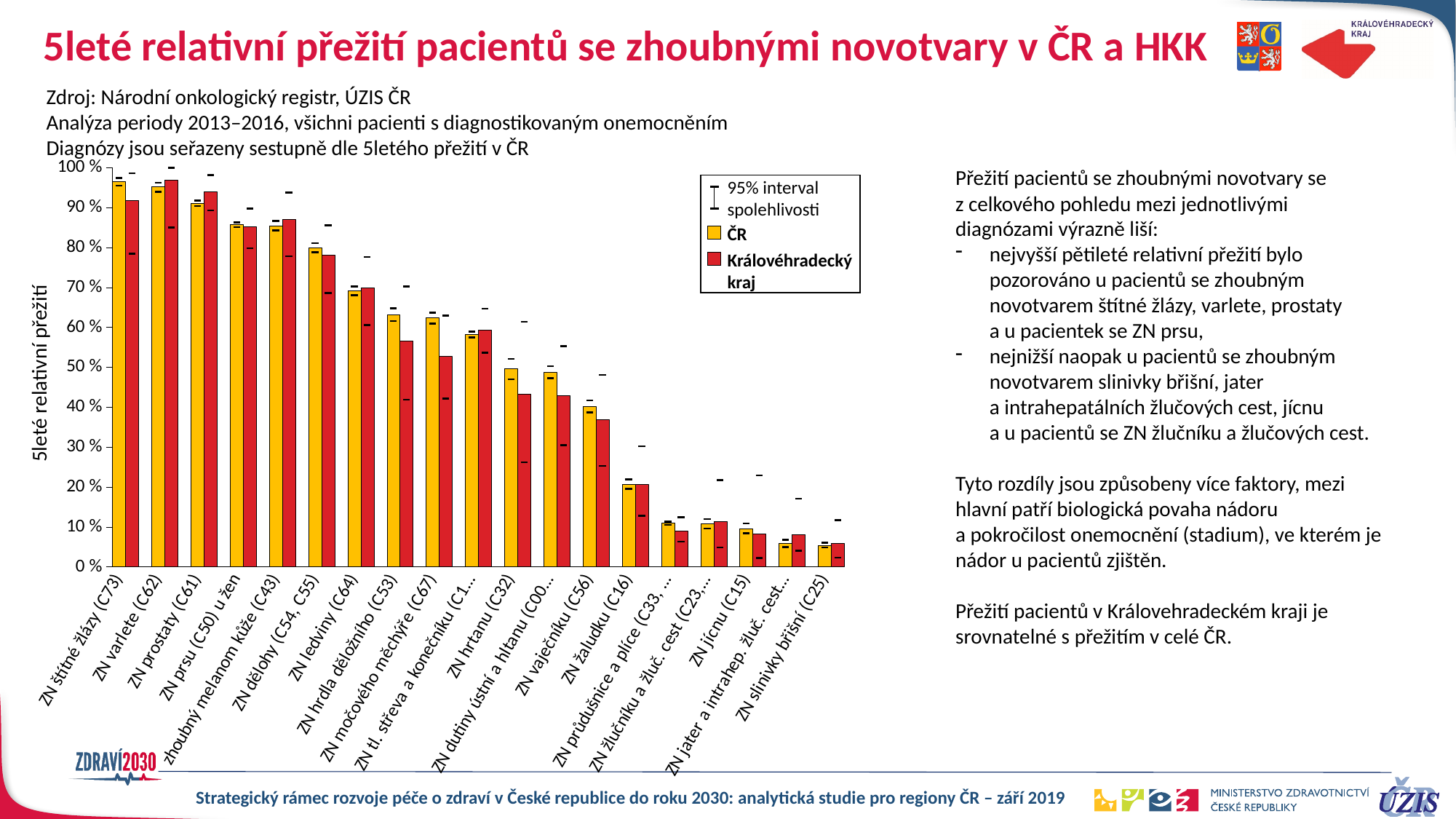
Which diagnosis has the highest 5-year relative survival for ČR? ZN štítné žlázy (C73) Is the Královéhradecký kraj value for ZN hrtanu (C32) greater or less than 50 %? less How many bar series (regions) does the chart compare? 2 What is the label of the y axis of the chart? 5leté relativní přežití What kind of chart is shown on the slide? bar chart Is the ČR value for ZN močového měchýře (C67) greater or less than 60 %? greater How many diagnoses (categories) are shown on the x axis of the chart? 19 Which diagnosis has the lowest 5-year relative survival for ČR? ZN slinivky břišní (C25) Is the Královéhradecký kraj value for ZN slinivky břišní (C25) greater or less than 10 %? less For ZN hrtanu (C32), which is larger: the ČR value or the Královéhradecký kraj value? ČR Do the ČR values rise or fall from left to right along the x axis? fall